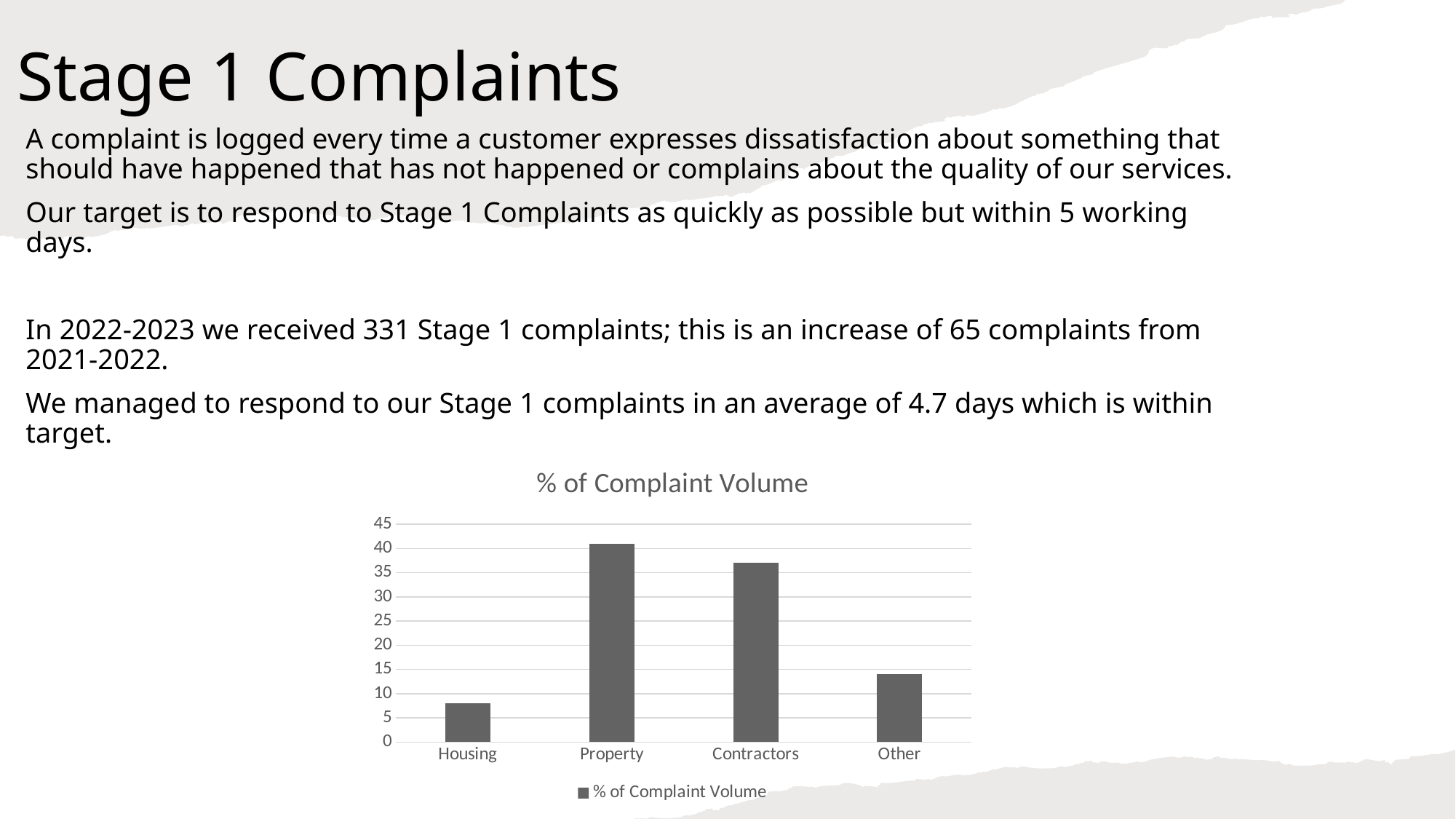
Is the value for Contractors greater or less than 30? greater What is the title of the chart? % of Complaint Volume Is the value for Other greater or less than 20? less How many categories are shown on the x axis of the chart? 4 Which category has the highest % of Complaint Volume? Property Is the value for Property greater or less than 35? greater Which is larger, the value for Contractors or the value for Other? Contractors What type of chart is shown on the slide? bar chart How many series does the chart legend list? 1 Which is larger, the value for Housing or the value for Other? Other Which category has the lowest % of Complaint Volume? Housing